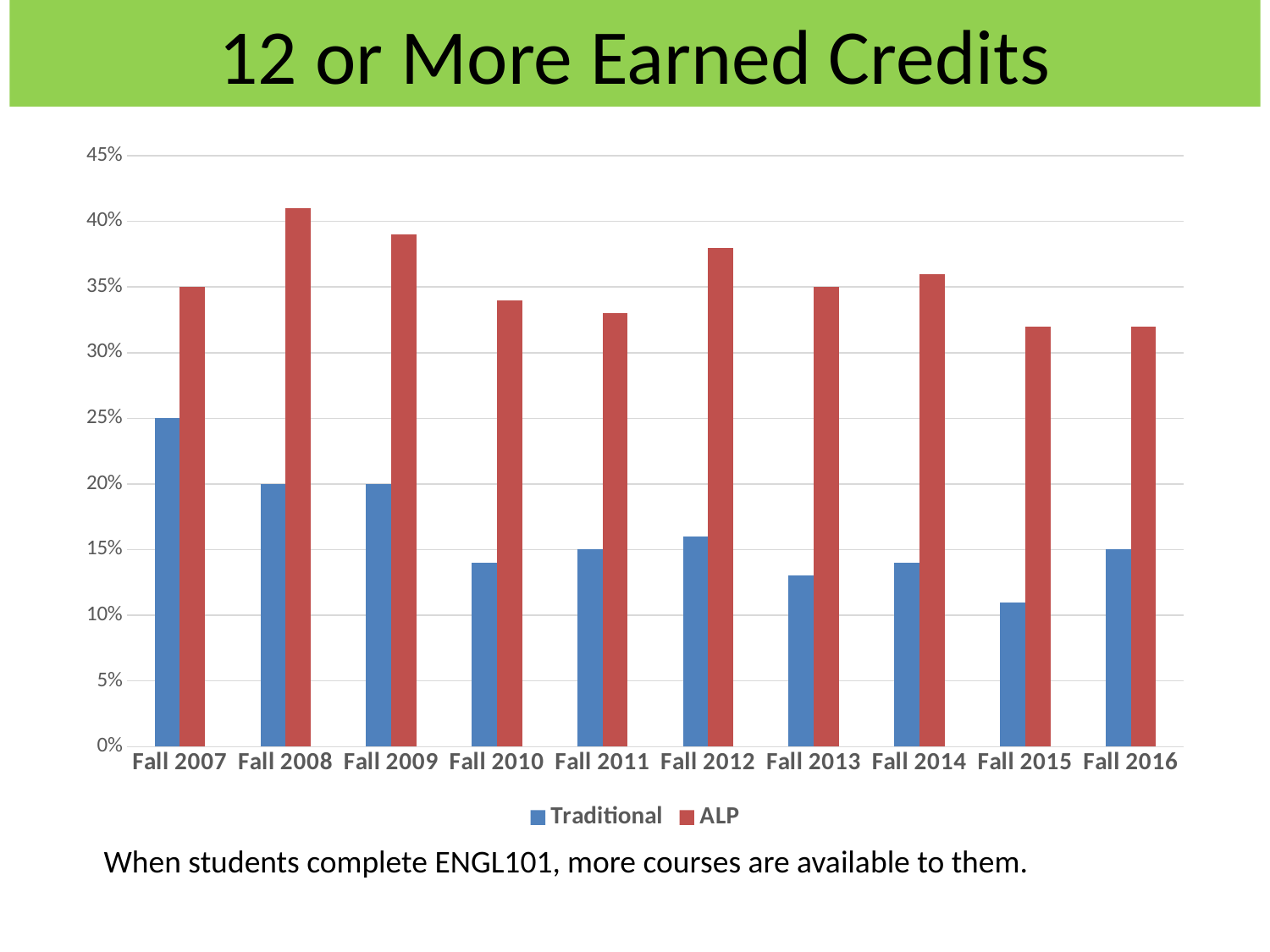
Which fall term has the lowest Traditional value? Fall 2015 Which fall term has the highest ALP value? Fall 2008 What is the ALP value for Fall 2013? 35% Is the ALP value for Fall 2012 greater or less than 35%? greater How many fall terms are shown on the x axis? 10 What is the Traditional value for Fall 2007? 25% What is the Traditional value for Fall 2008? 20% Which is larger for Fall 2010, the Traditional value or the ALP value? ALP How many series does the legend list? 2 What is the ALP value for Fall 2007? 35% Is the Traditional value for Fall 2013 greater or less than 15%? less What kind of chart is shown on the slide? bar chart